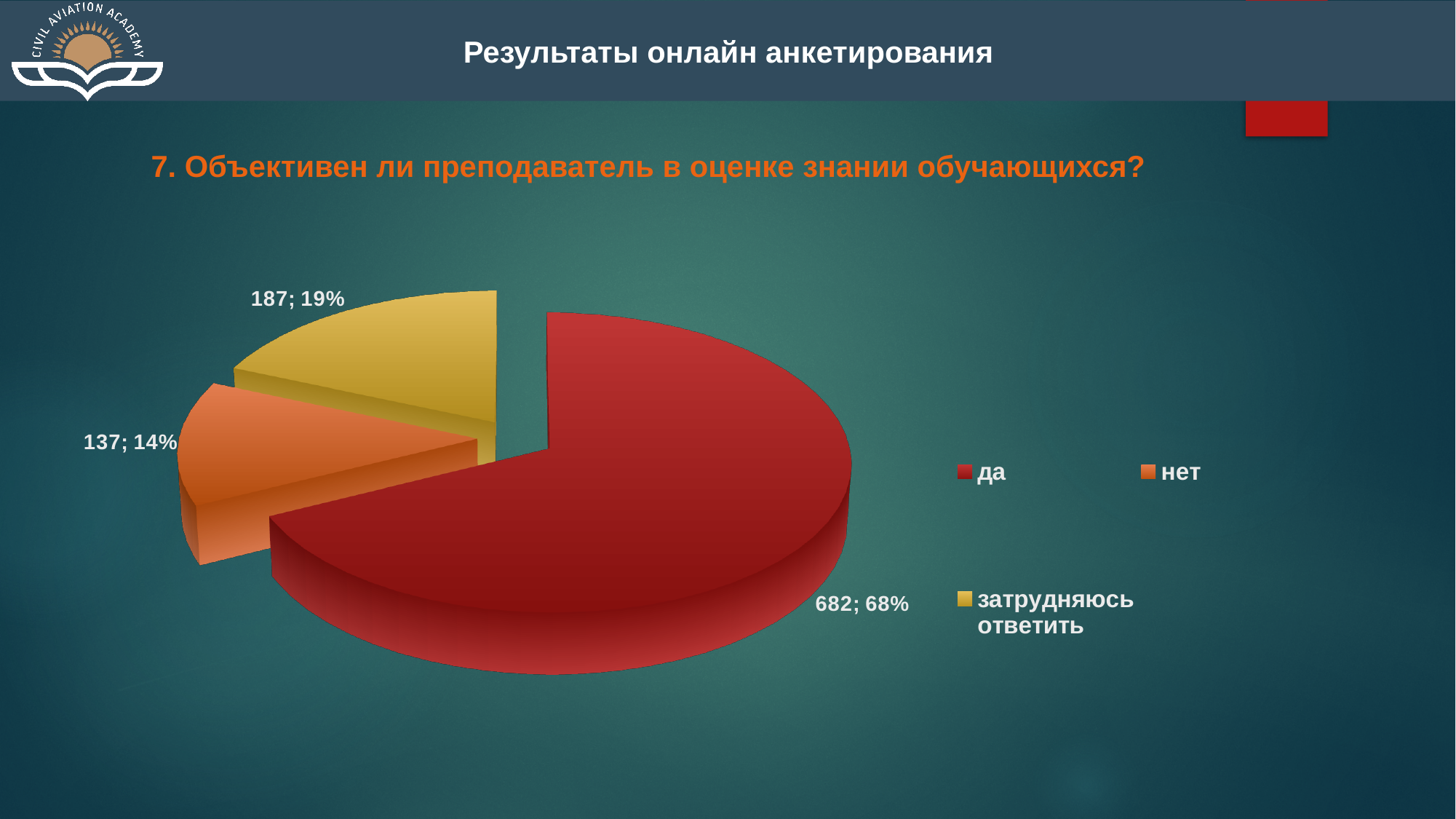
Which category has the smallest slice? нет What is the difference between the counts for "да" and "нет"? 545 What kind of chart is shown on the slide? pie chart Which colour represents "затрудняюсь ответить" in the legend? yellow What is the count for "нет"? 137 What is the count for "затрудняюсь ответить"? 187 How many slices does the pie chart have? 3 What share of the pie does "затрудняюсь ответить" represent? 19% How many entries does the legend list? 3 Which category has the largest slice? да What share of the pie does "да" represent? 68% What is the count for "да"? 682